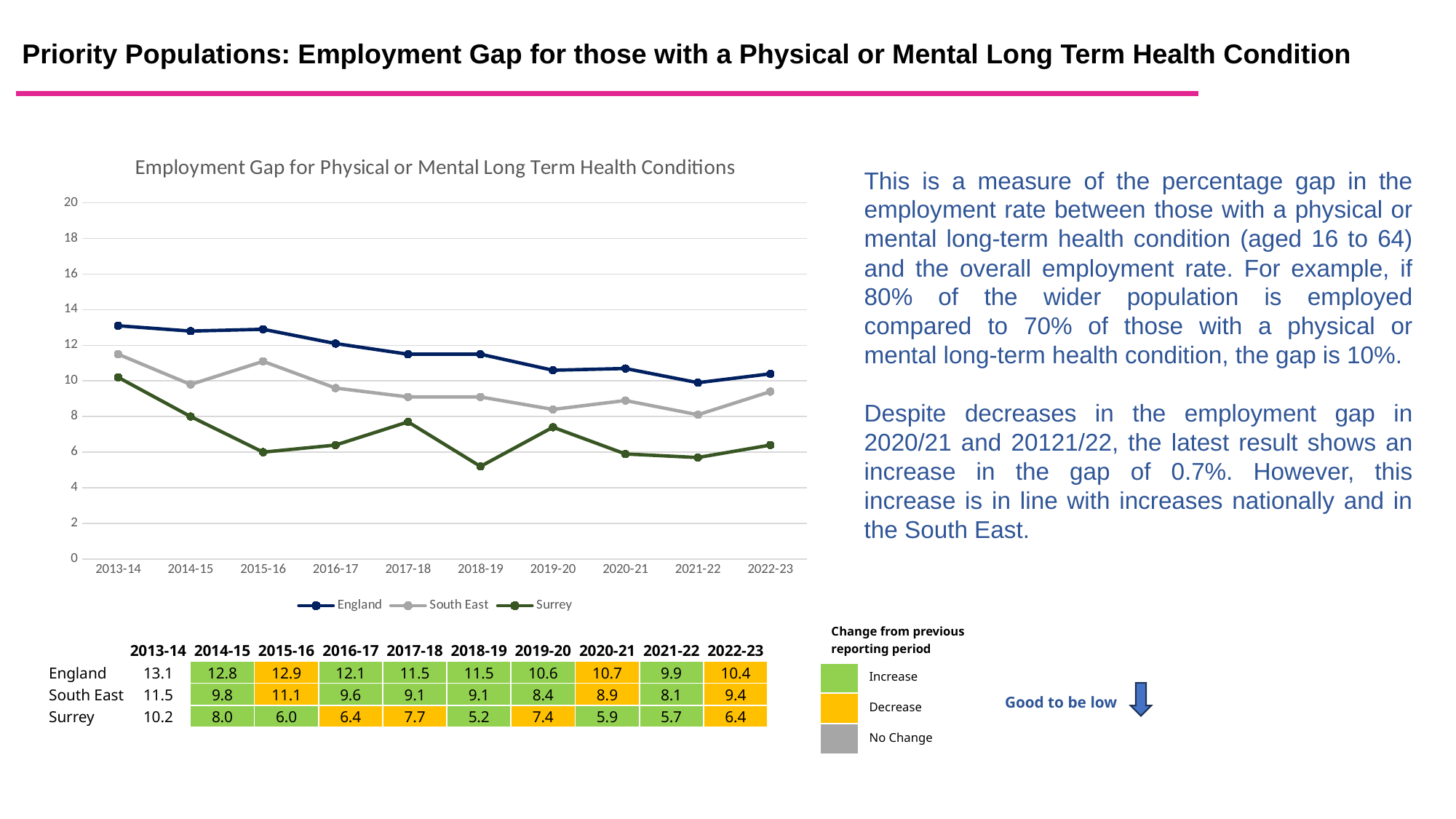
What is the employment gap for England in 2013-14? 13.1 What is the difference between the England and Surrey employment gaps in 2022-23? 4.0 What is the employment gap for Surrey in 2018-19? 5.2 Does the England employment gap generally rise or fall from 2013-14 to 2022-23? Fall How many reporting periods are plotted along the x axis? 10 What is the employment gap for South East in 2022-23? 9.4 Which has the larger employment gap in 2015-16, South East or Surrey? South East What is the title of the chart? Employment Gap for Physical or Mental Long Term Health Conditions In which reporting period is the Surrey employment gap lowest? 2018-19 In which reporting period is the England employment gap highest? 2013-14 How many series does the chart legend list? 3 What type of chart is shown on the slide? Line chart